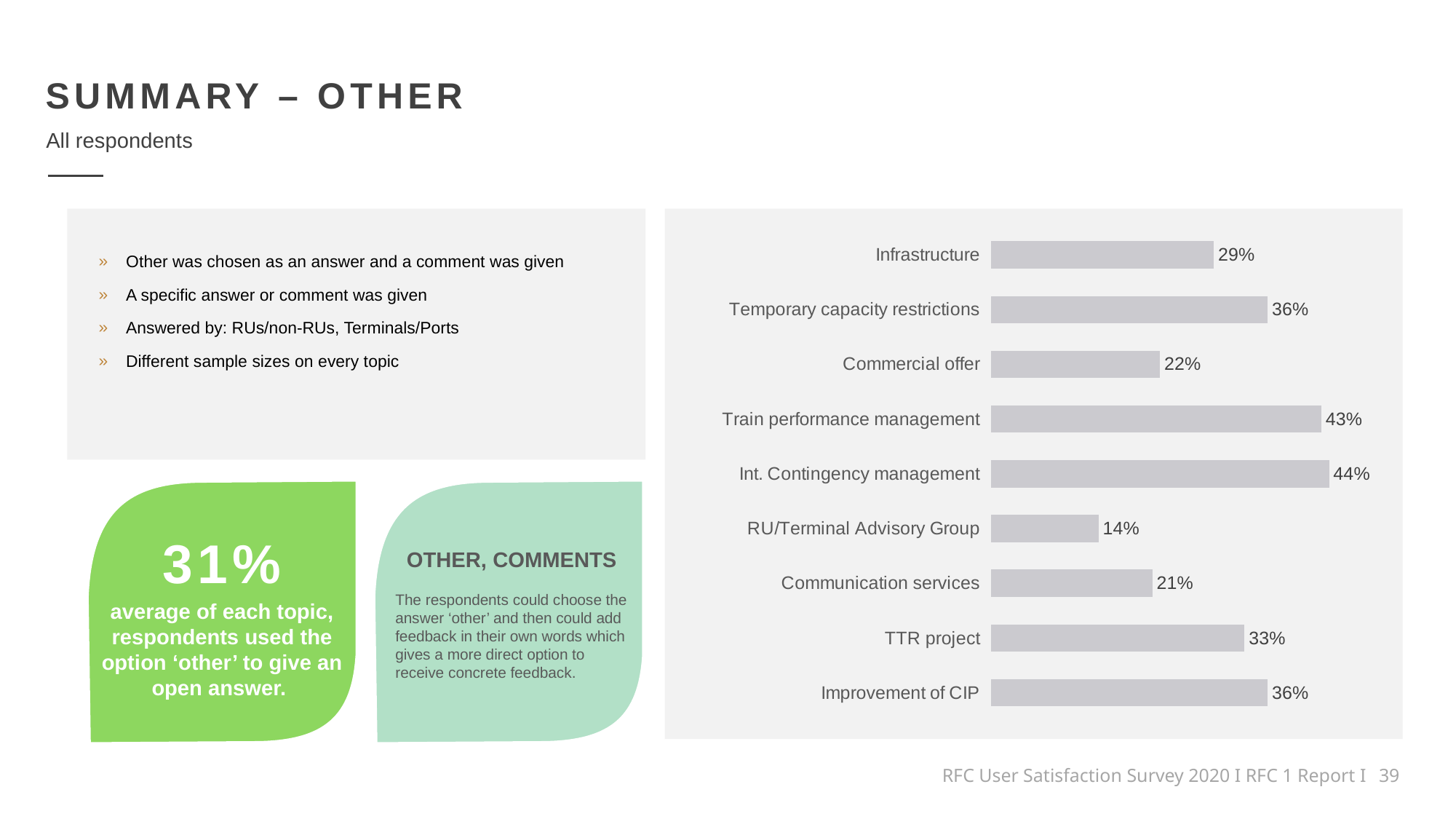
Which is larger, the value for Communication services or the value for Improvement of CIP? Improvement of CIP What is the difference between the values for Temporary capacity restrictions and Commercial offer? 14% Which category has the lowest value? RU/Terminal Advisory Group Which two categories share the value 36%? Temporary capacity restrictions and Improvement of CIP What is the value for Infrastructure? 29% What is the value for TTR project? 33% What is the difference between the values for Int. Contingency management and RU/Terminal Advisory Group? 30% What is the value for Train performance management? 43% How many categories are shown in the chart? 9 Which category has the highest value? Int. Contingency management What kind of chart is shown on the slide? Bar chart What is the value for RU/Terminal Advisory Group? 14%